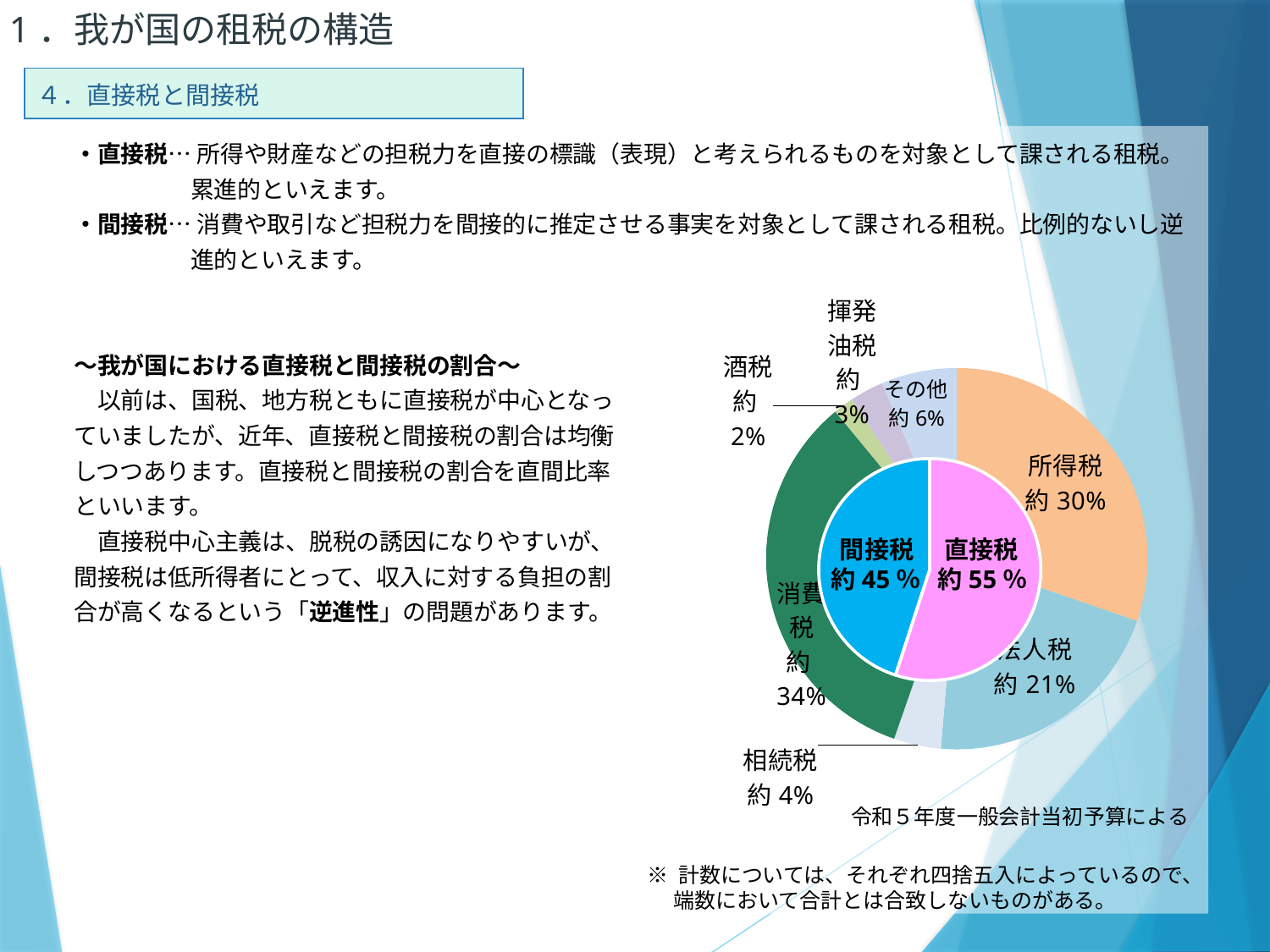
What is the value shown for 相続税 in the chart? 約 4% What is the value shown for 法人税 in the chart? 約 21% What is the value shown for 消費税 in the chart? 約 34% Which tax category in the outer ring has the largest share? 消費税 According to the note under the chart, which budget is the data based on? 令和５年度一般会計当初予算 What share does 間接税 have in the inner ring of the chart? 約 45％ How many tax categories are labelled in the outer ring of the chart? 7 What is the value shown for 所得税 in the chart? 約 30% What kind of chart is shown on the slide? Pie chart (doughnut) Which is larger in the inner ring, 直接税 or 間接税? 直接税 What share does 直接税 have in the inner ring of the chart? 約 55％ Which tax category in the outer ring has the smallest share? 酒税